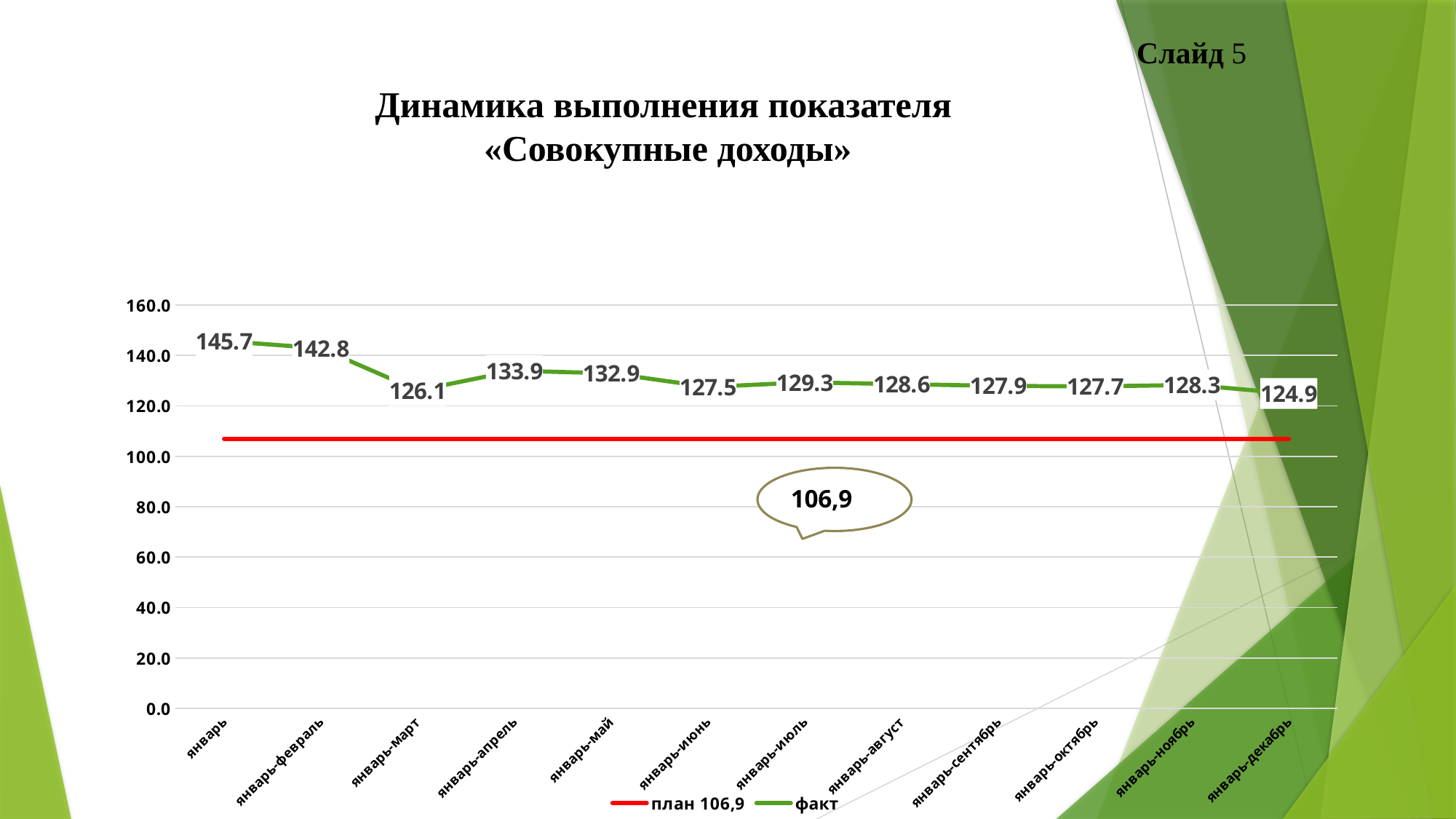
What is the value of the факт series for январь? 145.7 What is the value of the факт series for январь-декабрь? 124.9 How many periods are shown on the x axis? 12 Which is larger, the факт value for январь-апрель or for январь-июнь? январь-апрель What is the value of the факт series for январь-март? 126.1 How many series does the legend list? 2 What value does the план line represent, as shown in the callout? 106,9 Which period has the lowest факт value? январь-декабрь Which period has the highest факт value? январь What is the difference between the факт values for январь and январь-февраль? 2.9 What kind of chart is shown on the slide? line chart Is the факт value for январь-июль greater or less than 120? greater